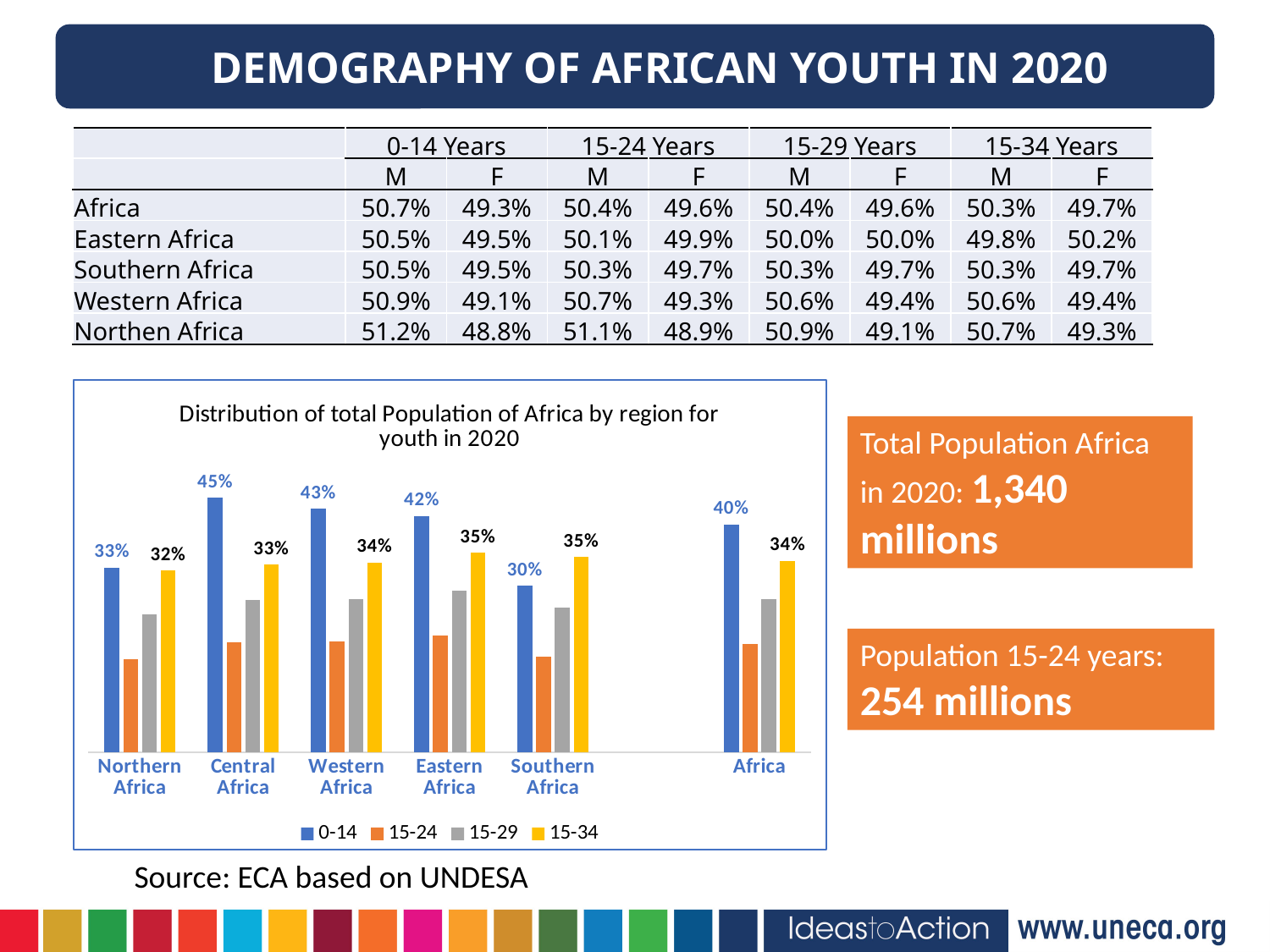
Which region has the lowest value for the 0-14 series? Southern Africa How many regions (categories) are shown on the x axis of the chart? 6 How many series does the chart's legend list? 4 What is the value of the 0-14 series for Africa as a whole? 40% What is the value of the 0-14 series for Central Africa? 45% What is the difference between the 0-14 values for Central Africa and Southern Africa? 15% Which region has the highest value for the 0-14 series? Central Africa What type of chart is shown on the slide? bar chart What is the title of the chart on the slide? Distribution of total Population of Africa by region for youth in 2020 For Northern Africa, which is larger: the 0-14 value or the 15-24 value? 0-14 Which series in the chart is shown in orange? 15-24 What is the value of the 15-34 series for Eastern Africa? 35%